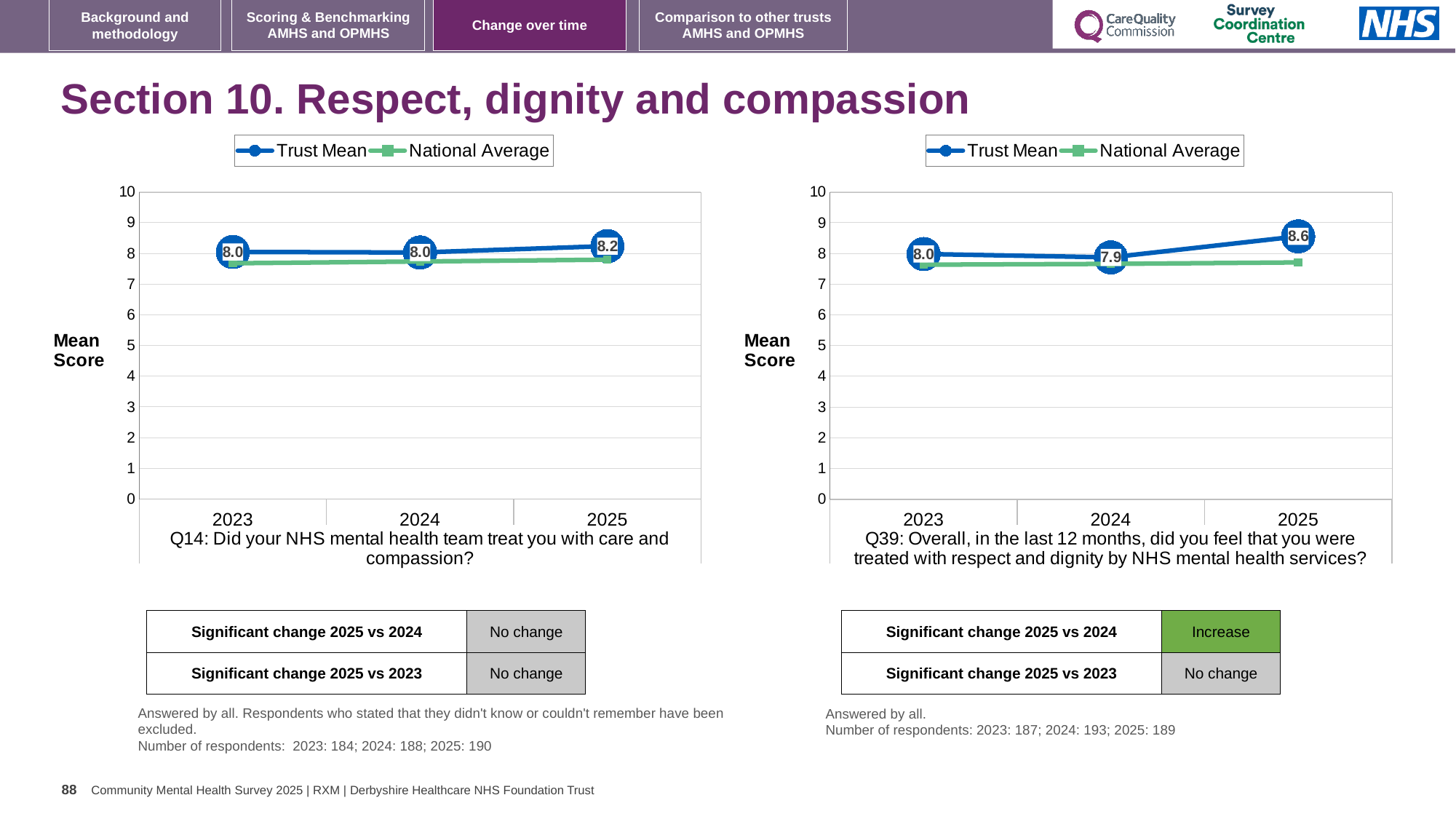
On the Q39 chart (right), which year has the highest Trust Mean? 2025 On the Q39 chart (right), what is the Trust Mean for 2024? 7.9 On the Q39 chart (right), is the National Average for 2025 greater or less than 8? less How many series does the legend of the Q39 chart (right) list? 2 How many years are plotted on the x axis of the Q14 chart (left)? 3 What type of chart is the Q14 chart (left)? Line chart On the Q39 chart (right), which year has the lowest Trust Mean? 2024 On the Q14 chart (left), is the Trust Mean higher in 2025 or in 2023? 2025 On the Q14 chart (left), what is the Trust Mean for 2025? 8.2 On the Q39 chart (right), what is the Trust Mean for 2025? 8.6 On the Q39 chart (right), what is the difference between the Trust Mean in 2025 and in 2024? 0.7 On the Q14 chart (left), what is the Trust Mean for 2023? 8.0